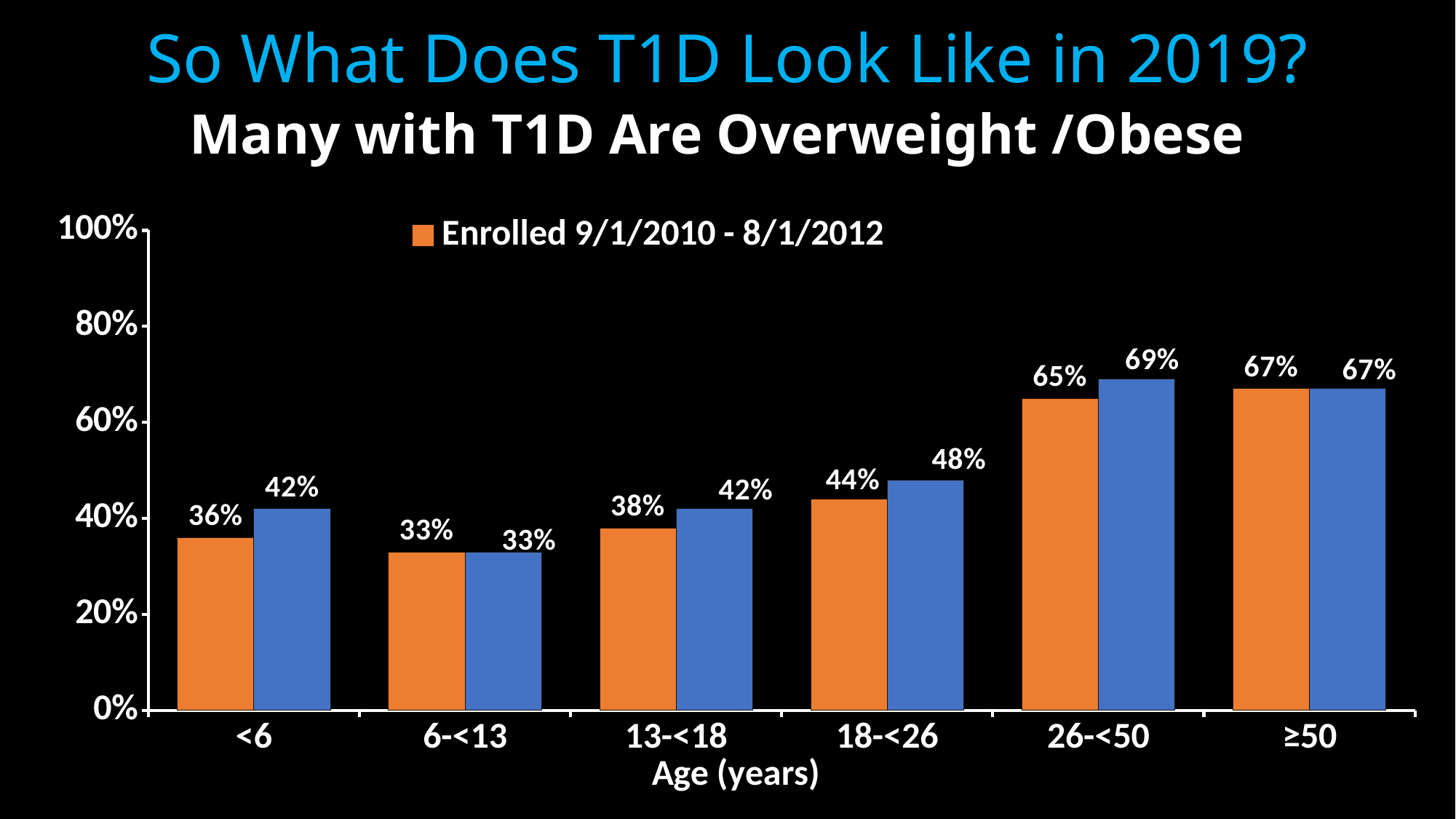
What is the difference between the blue bar and the orange bar for the 13-<18 age group? 4% Which age group has the highest value for the blue bars? 26-<50 How many series does the legend list? 1 What is the value of the orange bar (Enrolled 9/1/2010 - 8/1/2012) for the <6 age group? 36% What kind of chart is shown on the slide? bar chart For the <6 age group, which is larger: the orange bar or the blue bar? the blue bar How many age categories are shown on the x axis? 6 What is the label of the x axis? Age (years) Which age group has the lowest value for the orange bars (Enrolled 9/1/2010 - 8/1/2012)? 6-<13 What is the value of the blue bar for the 18-<26 age group? 48% Is the value of the orange bar for the ≥50 age group greater or less than 60%? greater What is the value of the orange bar (Enrolled 9/1/2010 - 8/1/2012) for the 26-<50 age group? 65%